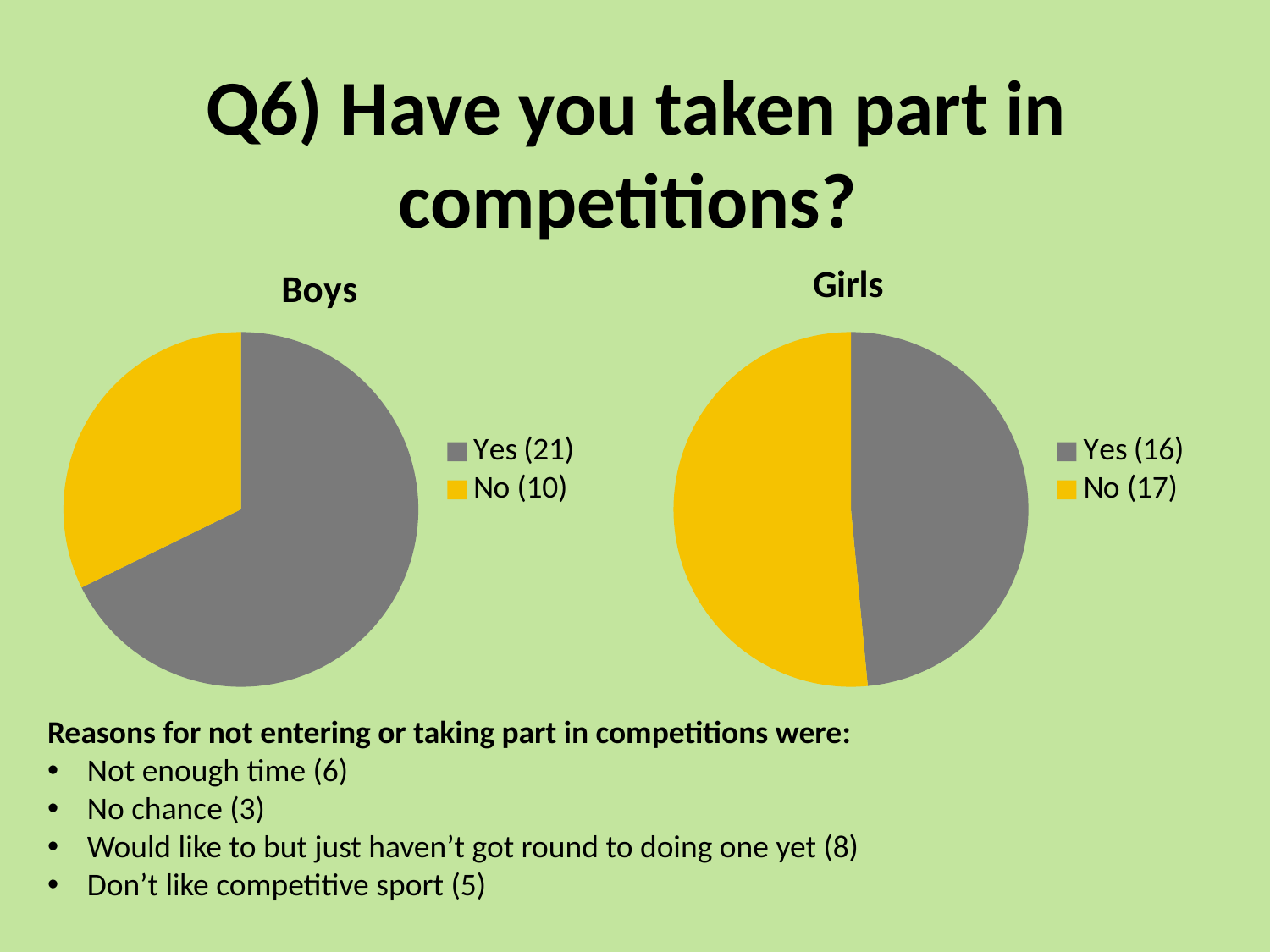
In the Boys chart, how many boys answered No? 10 In the Girls chart, how many girls answered No? 17 How many slices does the Girls chart have? 2 In the Girls chart, how many girls answered Yes? 16 Is the number of boys who answered Yes larger or smaller than the number of girls who answered Yes? larger In the Boys chart, what is the difference between the number of Yes and No answers? 11 In the Girls chart, what colour is the No slice? yellow What kind of chart is the Boys chart? pie chart In the Boys chart, what share of the total responses is the Yes slice, as a fraction? 21/31 In the Boys chart, how many boys answered Yes? 21 In the Boys chart, which answer has the larger slice? Yes (21) In the Girls chart, which answer has the smaller slice? Yes (16)